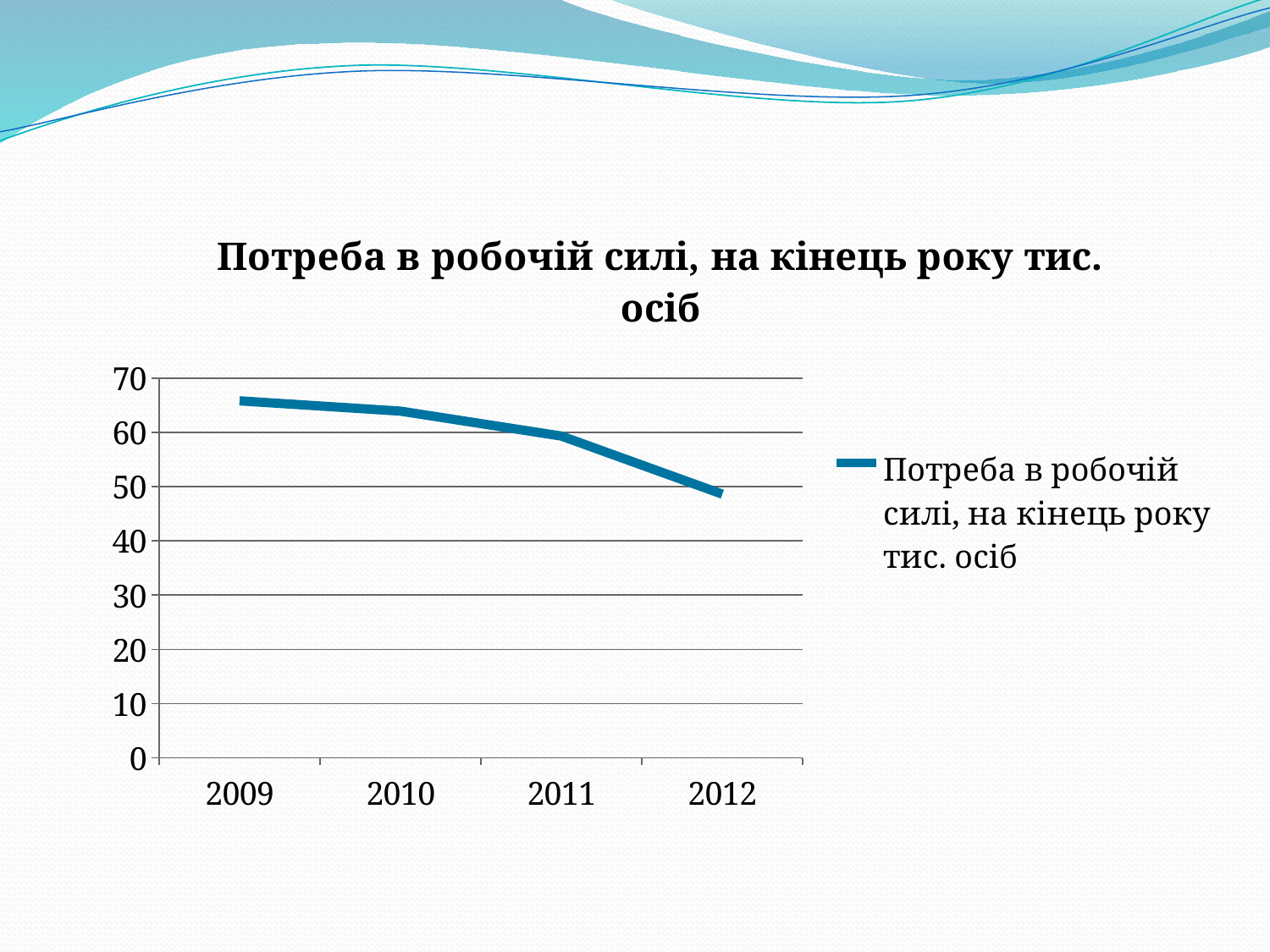
Which year has the highest value? 2009 How many series does the legend list? 1 Is the value for 2011 greater or less than 50? greater Which is larger, the value for 2009 or the value for 2012? 2009 Is the value for 2012 greater or less than 60? less Which year has the lowest value? 2012 Is the value for 2009 greater or less than 60? greater Which is larger, the value for 2010 or the value for 2011? 2010 What is the title of the chart? Потреба в робочій силі, на кінець року тис. осіб Do the values rise or fall from 2009 to 2012? fall How many years are plotted on the x axis? 4 What kind of chart is shown on the slide? line chart